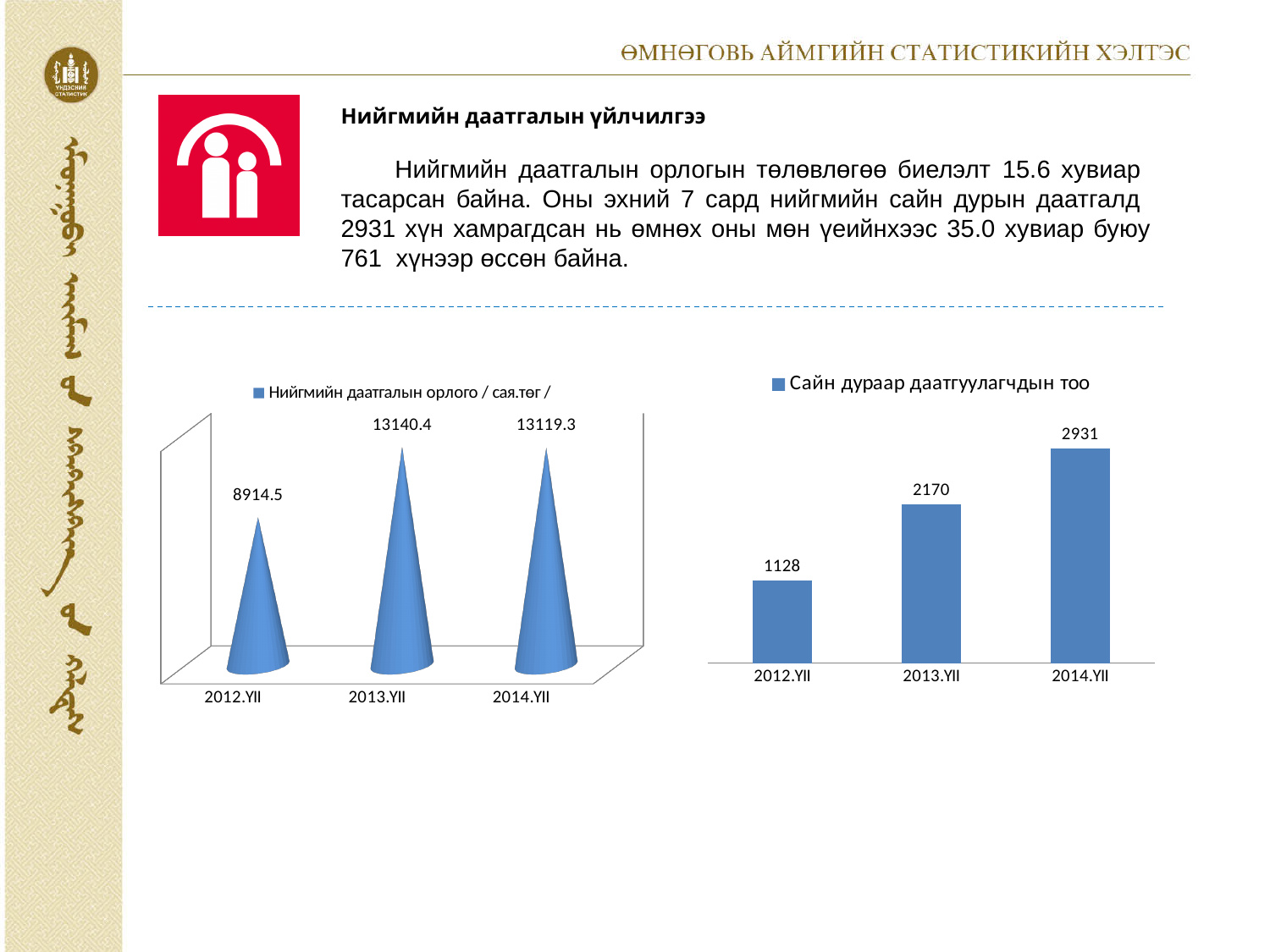
In the right chart (Сайн дураар даатгуулагчдын тоо), what is the value for 2012.YII? 1128 In the left chart (Нийгмийн даатгалын орлого / сая.төг /), what is the value for 2014.YII? 13119.3 In the right chart (Сайн дураар даатгуулагчдын тоо), what is the value for 2013.YII? 2170 In the right chart (Сайн дураар даатгуулагчдын тоо), do the values rise or fall from 2012.YII to 2014.YII? rise What kind of chart is the right chart (Сайн дураар даатгуулагчдын тоо)? bar chart In the left chart (Нийгмийн даатгалын орлого / сая.төг /), what is the value for 2013.YII? 13140.4 In the left chart (Нийгмийн даатгалын орлого / сая.төг /), which year has the lowest value? 2012.YII How many categories are shown on the x axis of the right chart (Сайн дураар даатгуулагчдын тоо)? 3 In the right chart (Сайн дураар даатгуулагчдын тоо), which year has the highest value? 2014.YII In the left chart (Нийгмийн даатгалын орлого / сая.төг /), what is the difference between the 2013.YII and 2012.YII values? 4225.9 In the left chart (Нийгмийн даатгалын орлого / сая.төг /), what is the value for 2012.YII? 8914.5 In the right chart (Сайн дураар даатгуулагчдын тоо), what is the difference between the 2014.YII and 2013.YII values? 761